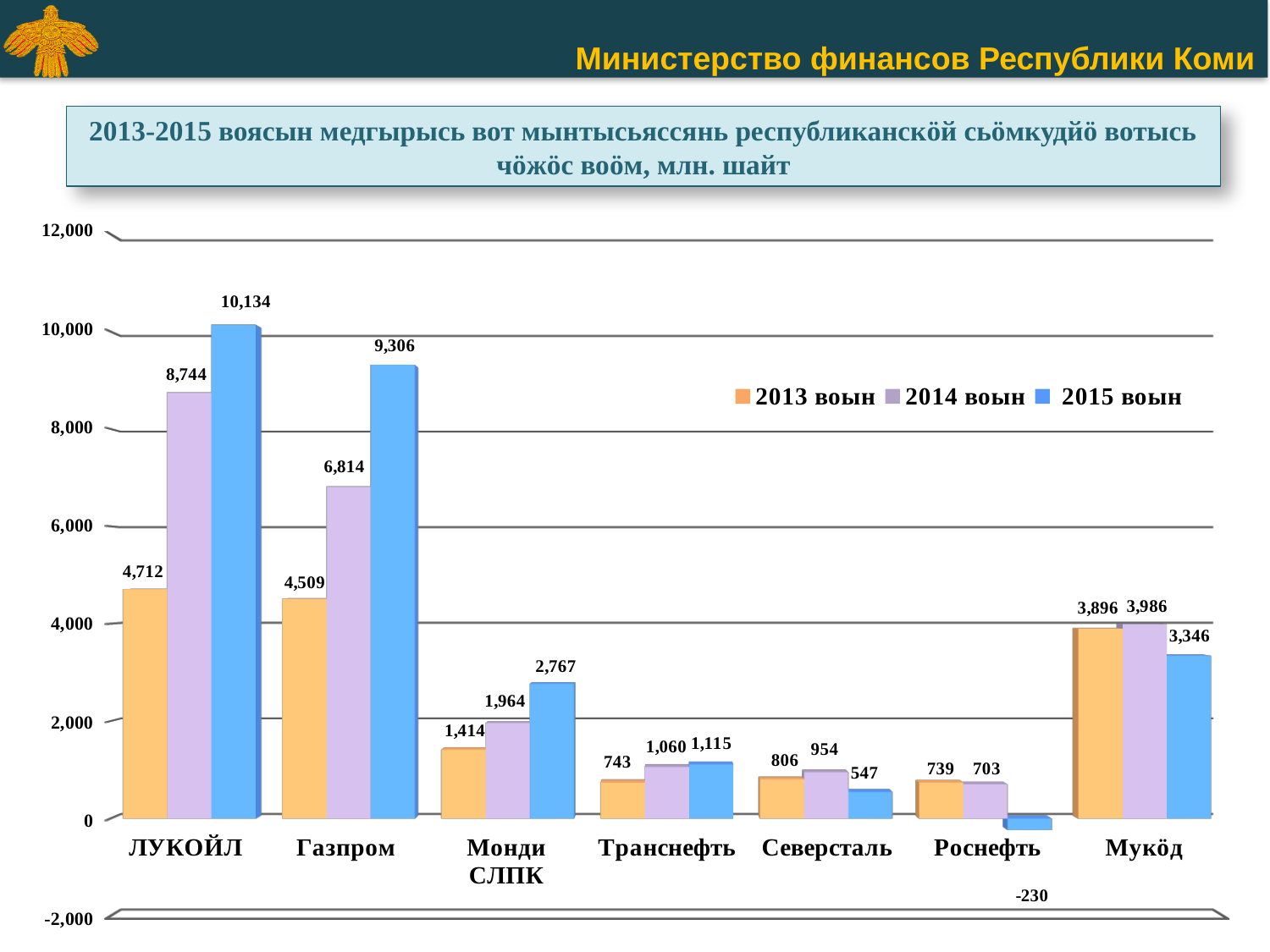
How many categories are shown on the x axis? 7 Which category has the highest value in the 2015 воын series? ЛУКОЙЛ What is the value for Роснефть in the 2015 воын series? -230 Do the values for ЛУКОЙЛ rise or fall from 2013 воын to 2015 воын? Rise What is the value for Газпром in the 2014 воын series? 6,814 What kind of chart is shown on the slide? Bar chart What is the value for ЛУКОЙЛ in the 2015 воын series? 10,134 Which is larger in the 2015 воын series: Транснефть or Северсталь? Транснефть What is the value for Мукöд in the 2013 воын series? 3,896 What is the difference between the 2015 воын and 2013 воын values for ЛУКОЙЛ? 5,422 Which category has the lowest value in the 2015 воын series? Роснефть How many series does the legend list? 3